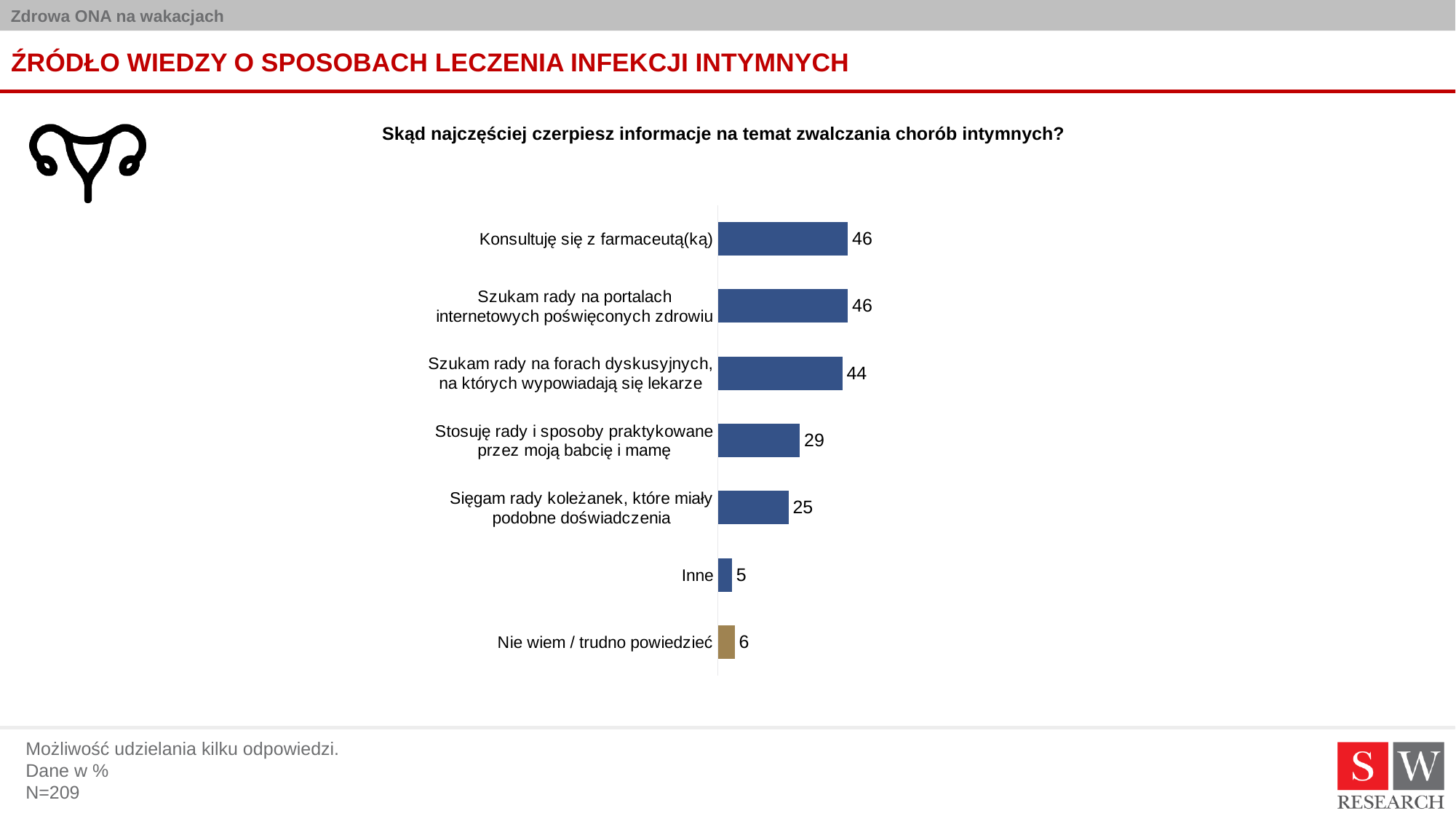
Which category has the lowest value? Inne What is the value for "Stosuję rady i sposoby praktykowane przez moją babcię i mamę"? 29 What is the value for "Nie wiem / trudno powiedzieć"? 6 What is the difference between the values for "Sięgam rady koleżanek, które miały podobne doświadczenia" and "Inne"? 20 How many categories are shown in the chart? 7 What is the value for "Szukam rady na forach dyskusyjnych, na których wypowiadają się lekarze"? 44 What is the value for "Konsultuję się z farmaceutą(ką)"? 46 What kind of chart is shown on the slide? Bar chart What question is shown as the chart's title? Skąd najczęściej czerpiesz informacje na temat zwalczania chorób intymnych? Which is larger: the value for "Szukam rady na forach dyskusyjnych, na których wypowiadają się lekarze" or for "Sięgam rady koleżanek, które miały podobne doświadczenia"? Szukam rady na forach dyskusyjnych, na których wypowiadają się lekarze What is the difference between the values for "Szukam rady na portalach internetowych poświęconych zdrowiu" and "Stosuję rady i sposoby praktykowane przez moją babcię i mamę"? 17 What is the value for "Sięgam rady koleżanek, które miały podobne doświadczenia"? 25